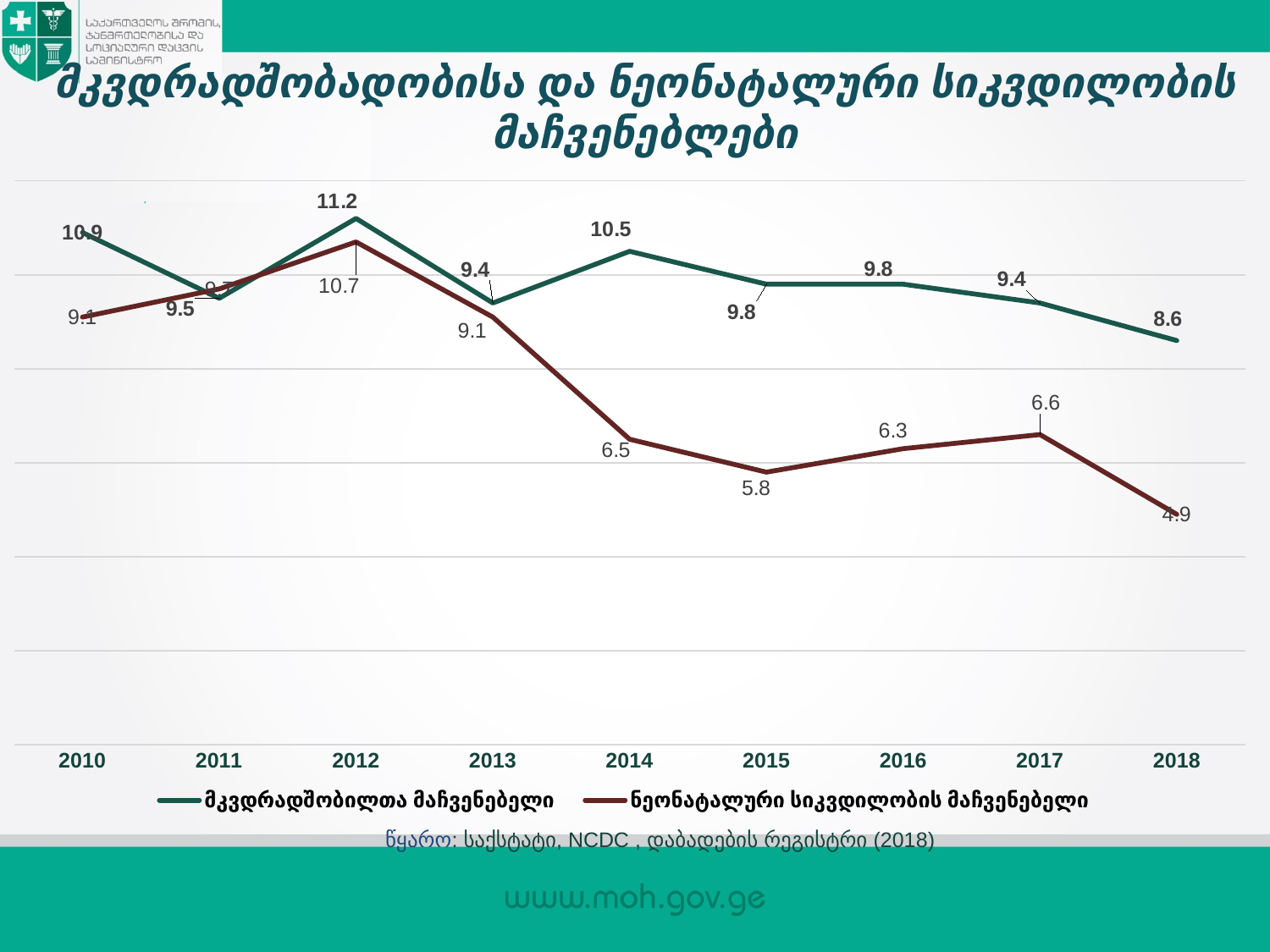
What kind of chart is shown on the slide? line chart Does the ნეონატალური სიკვდილობის მაჩვენებელი series overall rise or fall from 2012 to 2018? fall What is the difference between the ნეონატალური სიკვდილობის მაჩვენებელი values in 2017 and 2018? 1.7 What is the value of the ნეონატალური სიკვდილობის მაჩვენებელი (dark red) series in 2018? 4.9 In which year does the მკვდრადშობილთა მაჩვენებელი series reach its highest value? 2012 How many years are plotted along the x axis? 9 How many series does the legend list? 2 What is the value of the ნეონატალური სიკვდილობის მაჩვენებელი series in 2015? 5.8 In which year does the ნეონატალური სიკვდილობის მაჩვენებელი series reach its lowest value? 2018 What is the value of the მკვდრადშობილთა მაჩვენებელი (green) series in 2012? 11.2 In 2015, which series has the higher value? მკვდრადშობილთა მაჩვენებელი By how much did the მკვდრადშობილთა მაჩვენებელი series decrease from 2010 to 2018? 2.3